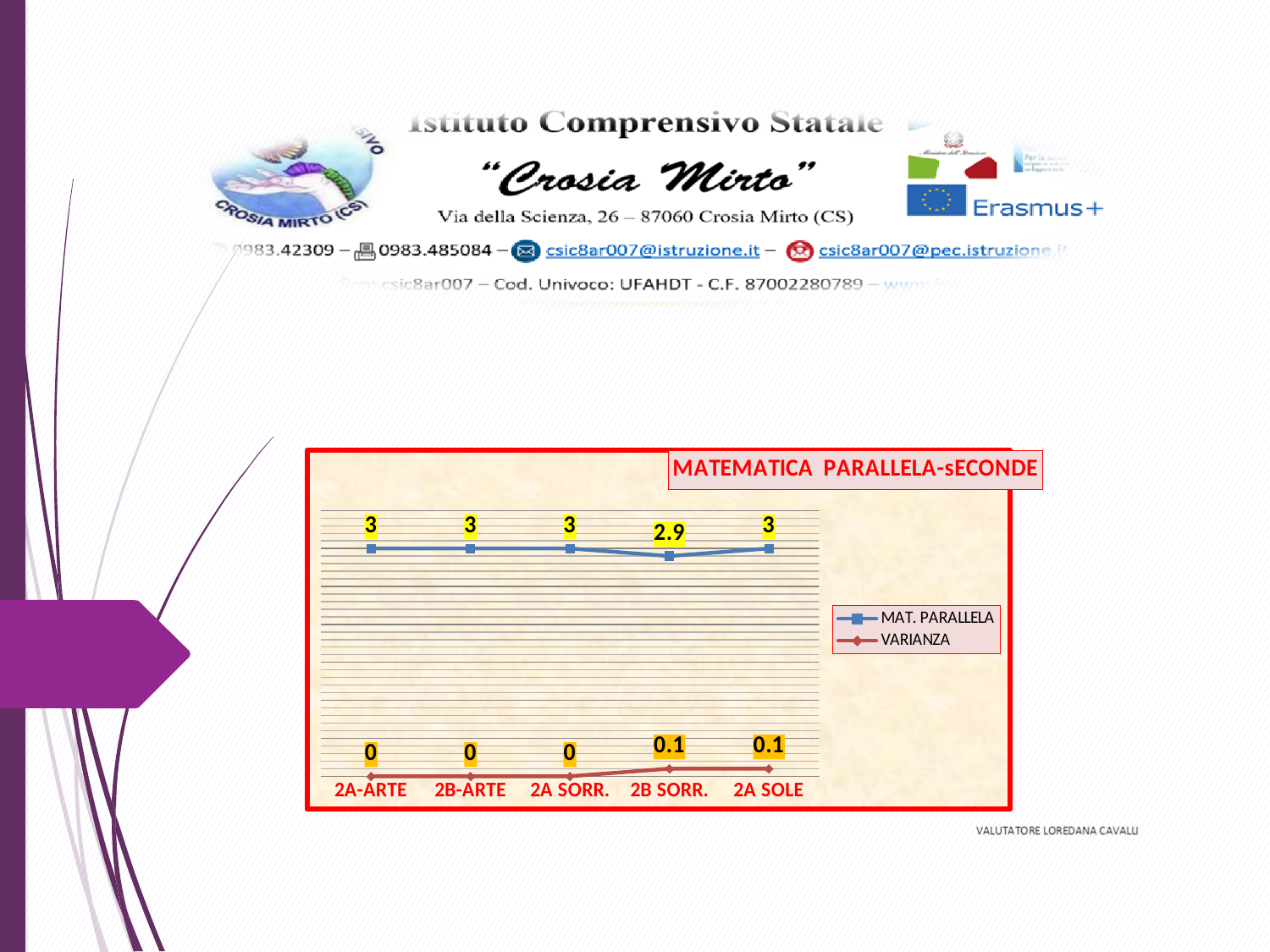
How many categories are shown on the x axis? 5 How many series does the legend list? 2 Which is larger, the VARIANZA value for 2B SORR. or for 2A SORR.? 2B SORR. Which series is drawn in blue in the legend? MAT. PARALLELA What is the MAT. PARALLELA value for 2A SOLE? 3 What type of chart is shown on the slide? line chart Which category has the lowest MAT. PARALLELA value? 2B SORR. What is the difference between the MAT. PARALLELA values for 2A-ARTE and 2B SORR.? 0.1 What is the title of the chart? MATEMATICA PARALLELA-sECONDE What is the MAT. PARALLELA value for 2B SORR.? 2.9 What is the VARIANZA value for 2A-ARTE? 0 What is the VARIANZA value for 2A SOLE? 0.1